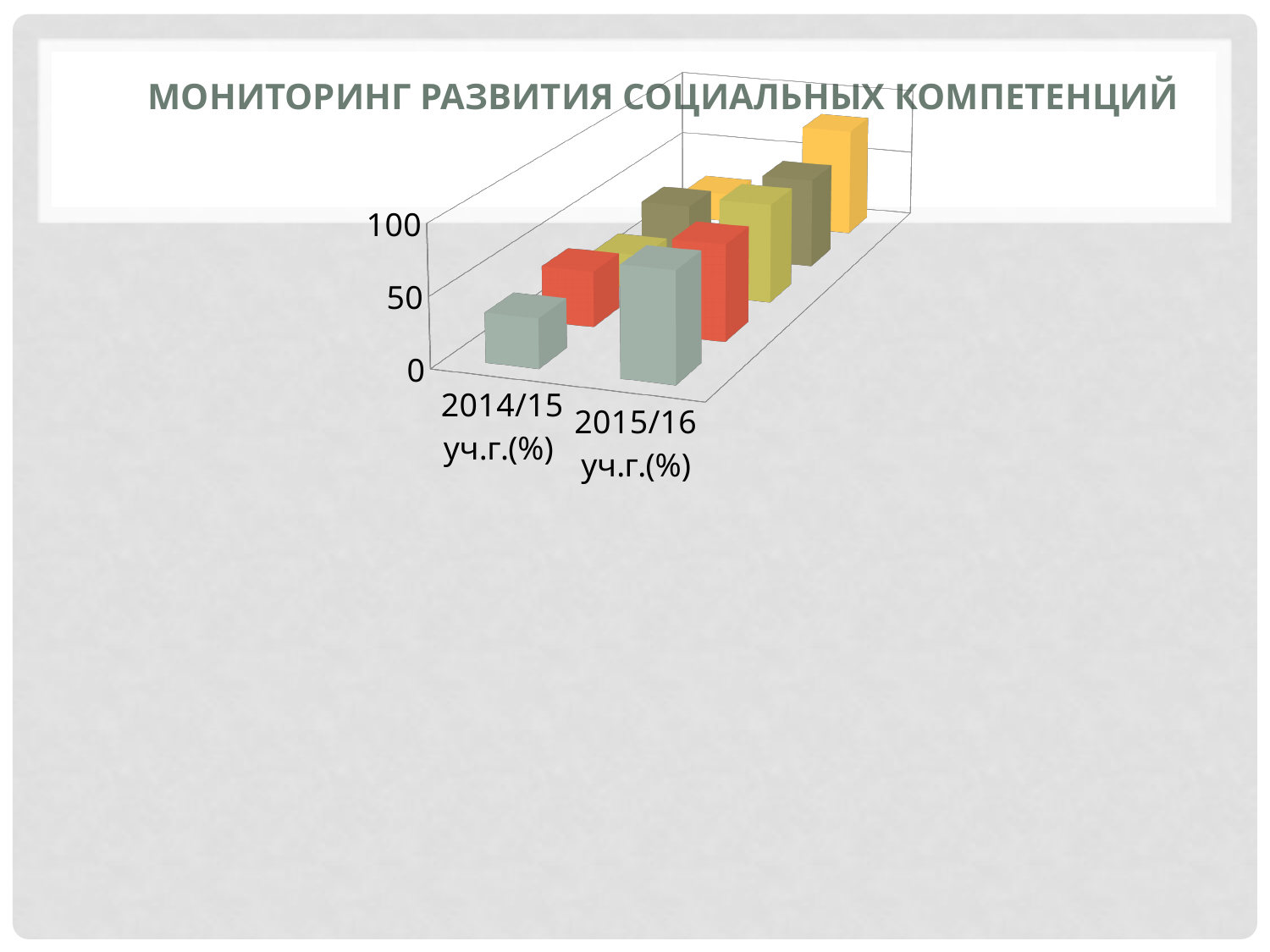
What is the highest value labelled on the vertical axis of the chart? 100 How many categories are shown on the x axis of the chart? 2 How many bars are plotted in total on the chart? 10 For the front grey series, which category has the larger value: 2014/15 уч.г.(%) or 2015/16 уч.г.(%)? 2015/16 уч.г.(%) What kind of chart is shown on the slide? bar chart What are the two categories on the x axis of the chart? 2014/15 уч.г.(%) and 2015/16 уч.г.(%) How many bars are plotted for the 2014/15 уч.г.(%) category? 5 For the yellow series at the back, which category has the larger value: 2014/15 уч.г.(%) or 2015/16 уч.г.(%)? 2015/16 уч.г.(%) Do the values rise or fall from 2014/15 уч.г.(%) to 2015/16 уч.г.(%)? rise